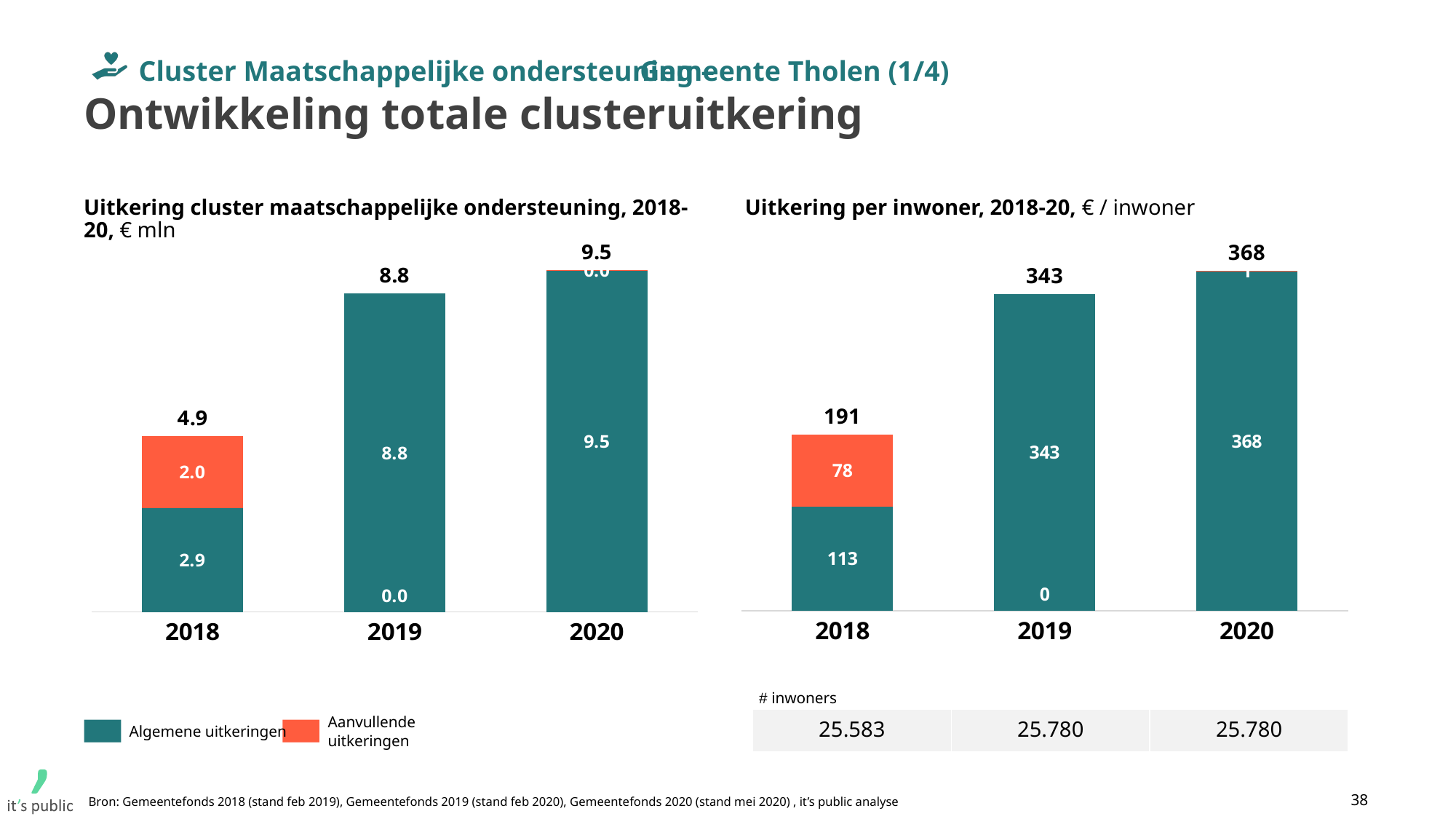
What type of chart is the left chart (Uitkering cluster maatschappelijke ondersteuning)? stacked bar chart In the left chart (Uitkering cluster maatschappelijke ondersteuning), what is the difference between the totals for 2020 and 2019? 0.7 In the right chart (Uitkering per inwoner), what is the value of Algemene uitkeringen in 2018? 113 In the right chart (Uitkering per inwoner), what is the total value for 2020? 368 In the left chart (Uitkering cluster maatschappelijke ondersteuning), what is the value of Algemene uitkeringen in 2019? 8.8 In the left chart (Uitkering cluster maatschappelijke ondersteuning), what is the total value for 2018? 4.9 In the left chart (Uitkering cluster maatschappelijke ondersteuning), do the totals rise or fall from 2018 to 2020? rise In the right chart (Uitkering per inwoner), what is the difference between the totals for 2019 and 2018? 152 In the right chart (Uitkering per inwoner), which year has the lowest total? 2018 How many series does the legend on the slide list? 2 In the left chart (Uitkering cluster maatschappelijke ondersteuning), what is the value of Aanvullende uitkeringen in 2018? 2.0 In the left chart (Uitkering cluster maatschappelijke ondersteuning), which year has the highest total? 2020